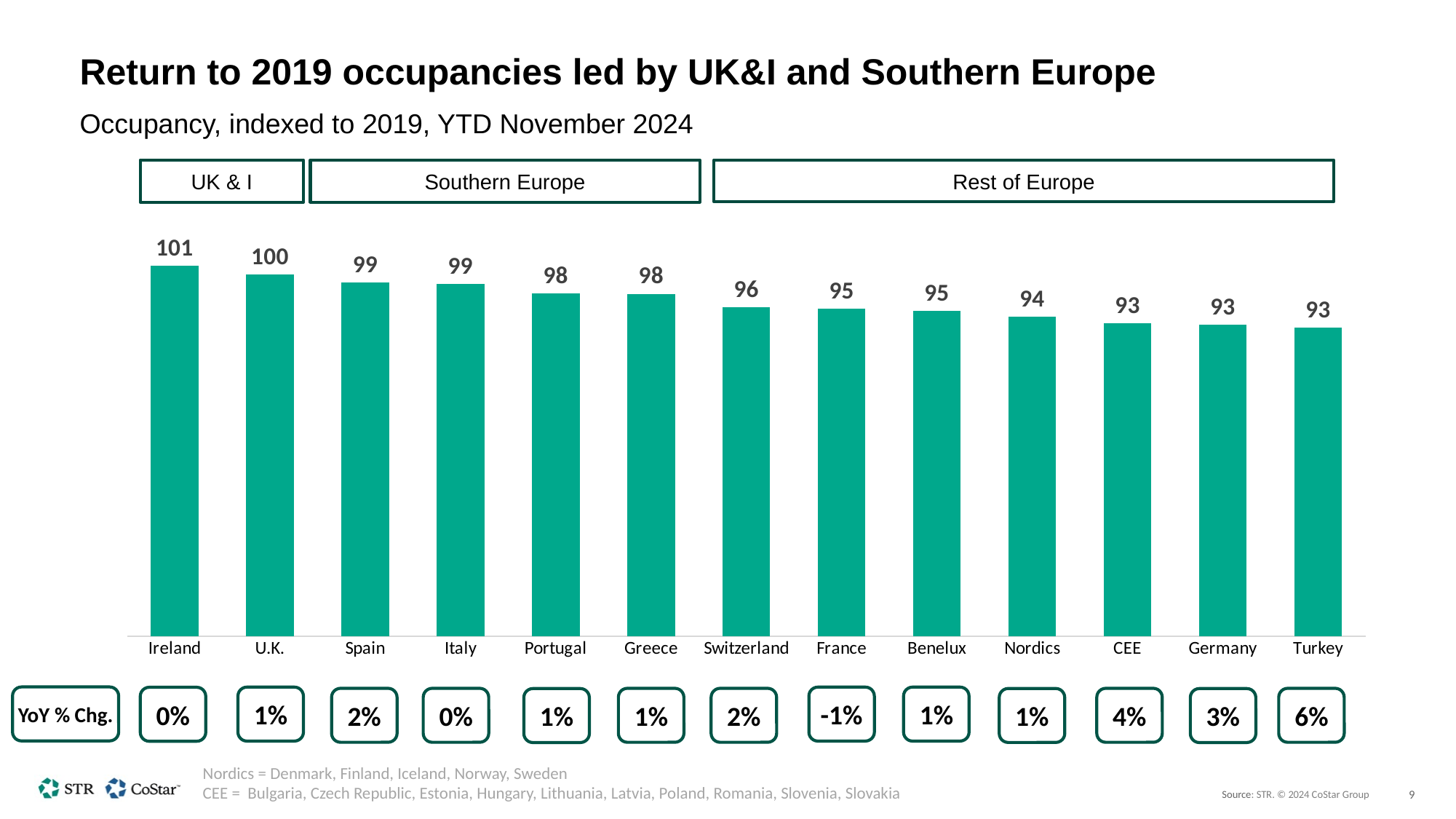
Which three regional groups are labelled above the chart? UK & I, Southern Europe, Rest of Europe What kind of chart is shown on the slide? Bar chart Do the occupancy index values rise or fall from left to right across the chart? Fall What is the occupancy index value for Switzerland? 96 What is the difference between the occupancy index values for Spain and France? 4 How many categories are shown on the chart? 13 Which category has the highest occupancy index value? Ireland What is the occupancy index value for Ireland? 101 What is the YoY % change shown for Turkey? 6% What is the difference between the occupancy index values for Ireland and Turkey? 8 Which has a higher occupancy index value, Portugal or Benelux? Portugal What is the occupancy index value for Nordics? 94